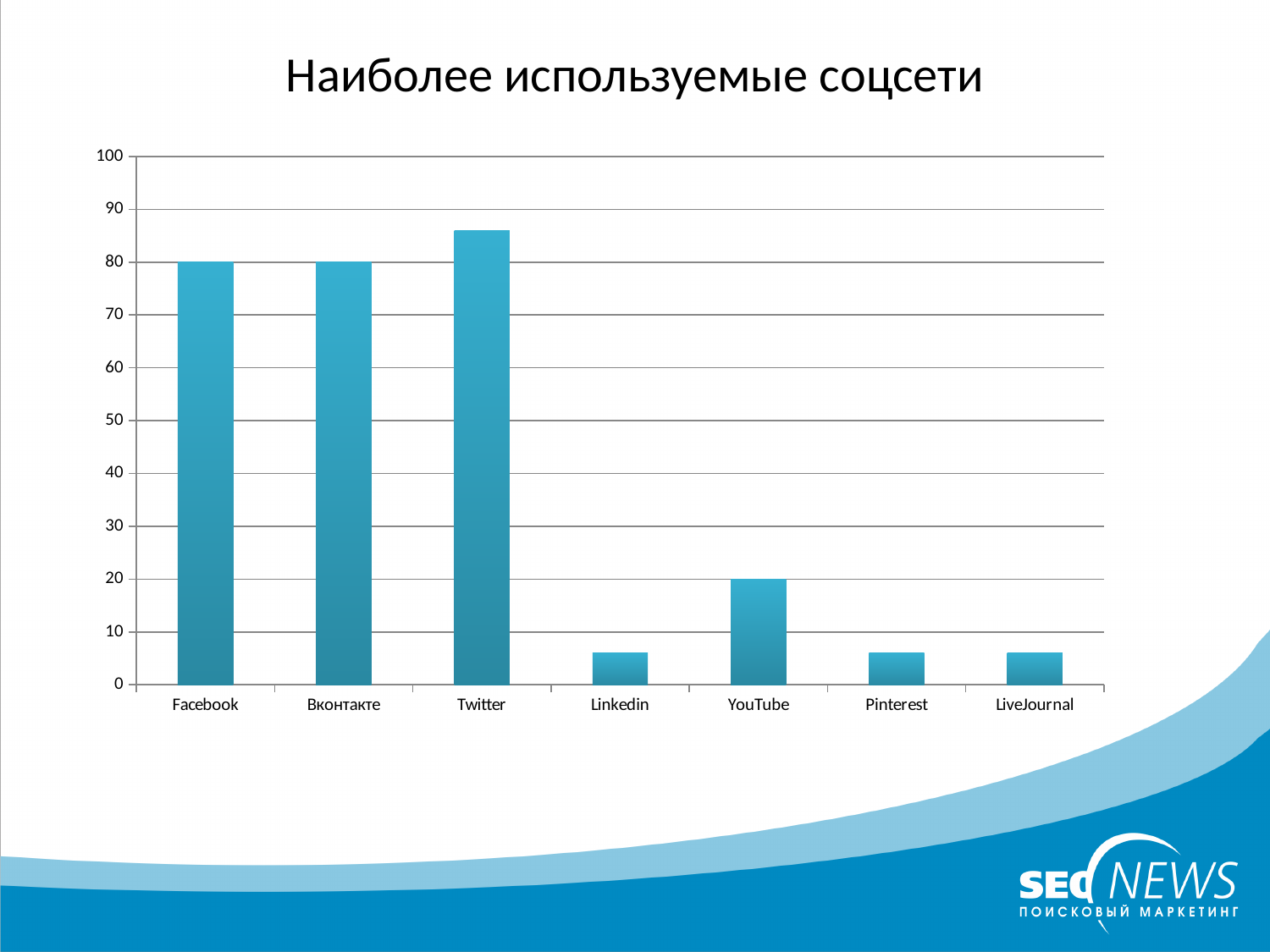
What is the value for YouTube? 20 What is the difference between the values for Facebook and YouTube? 60 Which is larger, the value for YouTube or the value for LiveJournal? YouTube What is the value for Facebook? 80 Is the value for Linkedin greater or less than 10? less Which social network has the highest value? Twitter Is the value for Pinterest greater or less than 10? less What is the title of the chart? Наиболее используемые соцсети Is the value for Twitter greater or less than 80? greater How many social networks are shown on the x axis? 7 What is the value for Вконтакте? 80 What type of chart is shown on the slide? bar chart